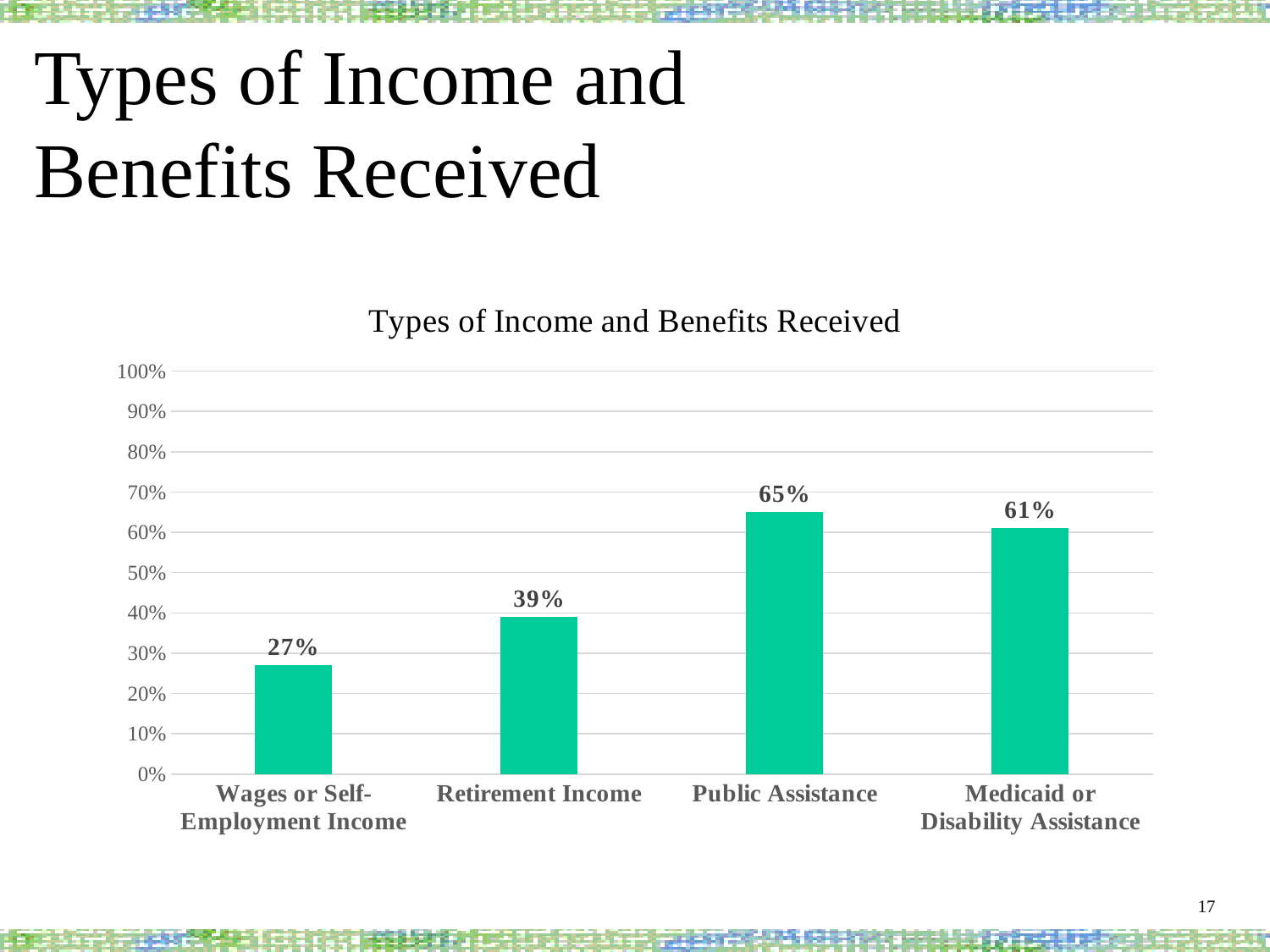
What is the value for Retirement Income? 39% What kind of chart is shown on the slide? bar chart What is the difference between the values for Medicaid or Disability Assistance and Wages or Self-Employment Income? 34% Which is larger, the value for Retirement Income or the value for Medicaid or Disability Assistance? Medicaid or Disability Assistance What is the value for Medicaid or Disability Assistance? 61% What is the value for Public Assistance? 65% Is the value for Retirement Income greater or less than 50%? less What is the difference between the values for Public Assistance and Retirement Income? 26% Which category has the highest value? Public Assistance Which category has the lowest value? Wages or Self-Employment Income How many categories are shown in the chart? 4 What is the value for Wages or Self-Employment Income? 27%